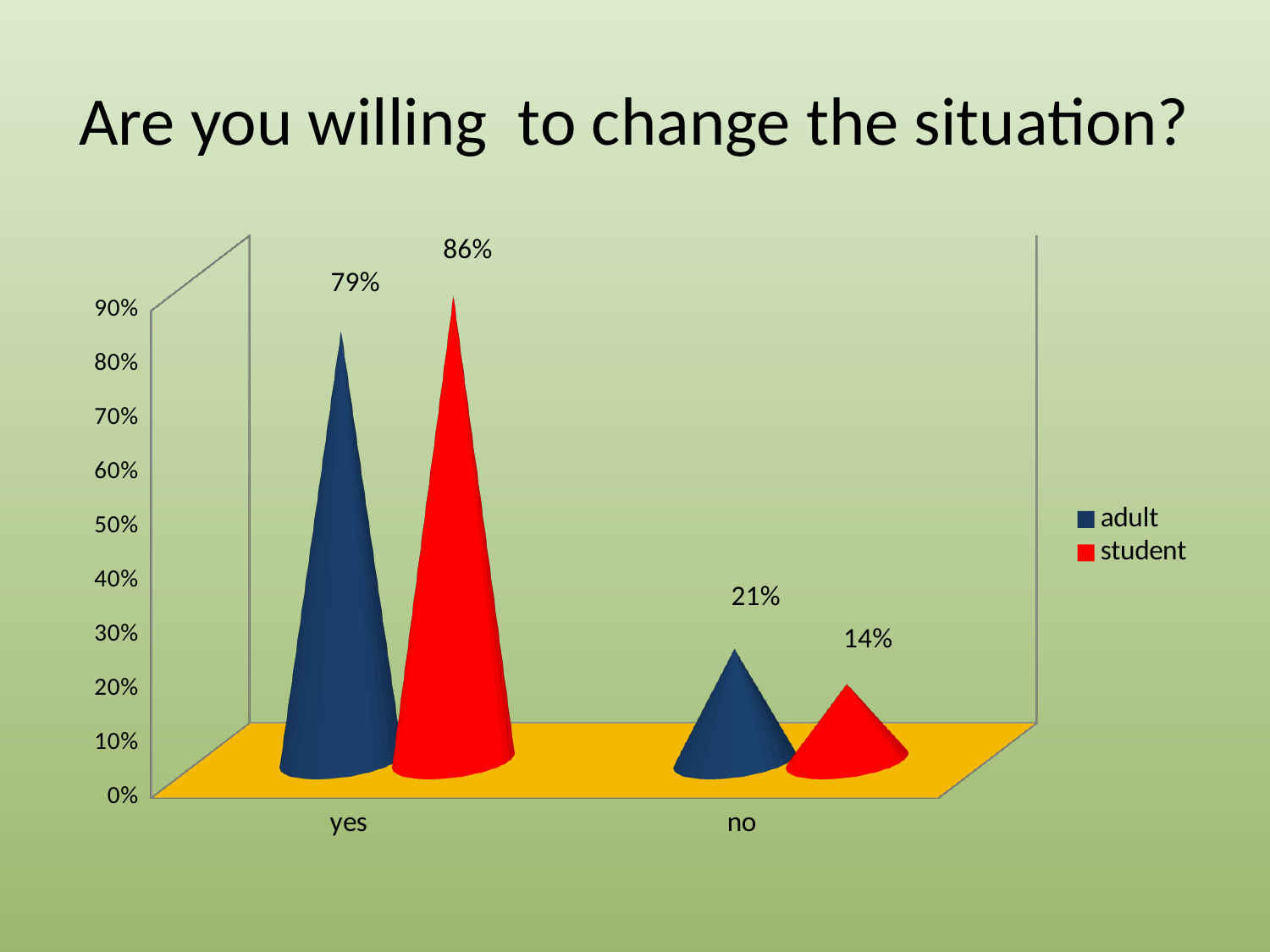
What percentage of adults answered "no"? 21% What percentage of students answered "yes"? 86% Which group has the higher value for "yes", adult or student? student What is the title of the chart? Are you willing to change the situation? What is the difference between the student and adult values for "yes"? 7% What is the difference between the adult and student values for "no"? 7% What percentage of adults answered "yes"? 79% How many series does the legend list? 2 What percentage of students answered "no"? 14% How many answer categories are shown on the x axis? 2 Which group has the higher value for "no", adult or student? adult Which answer category has the lowest value for students? no